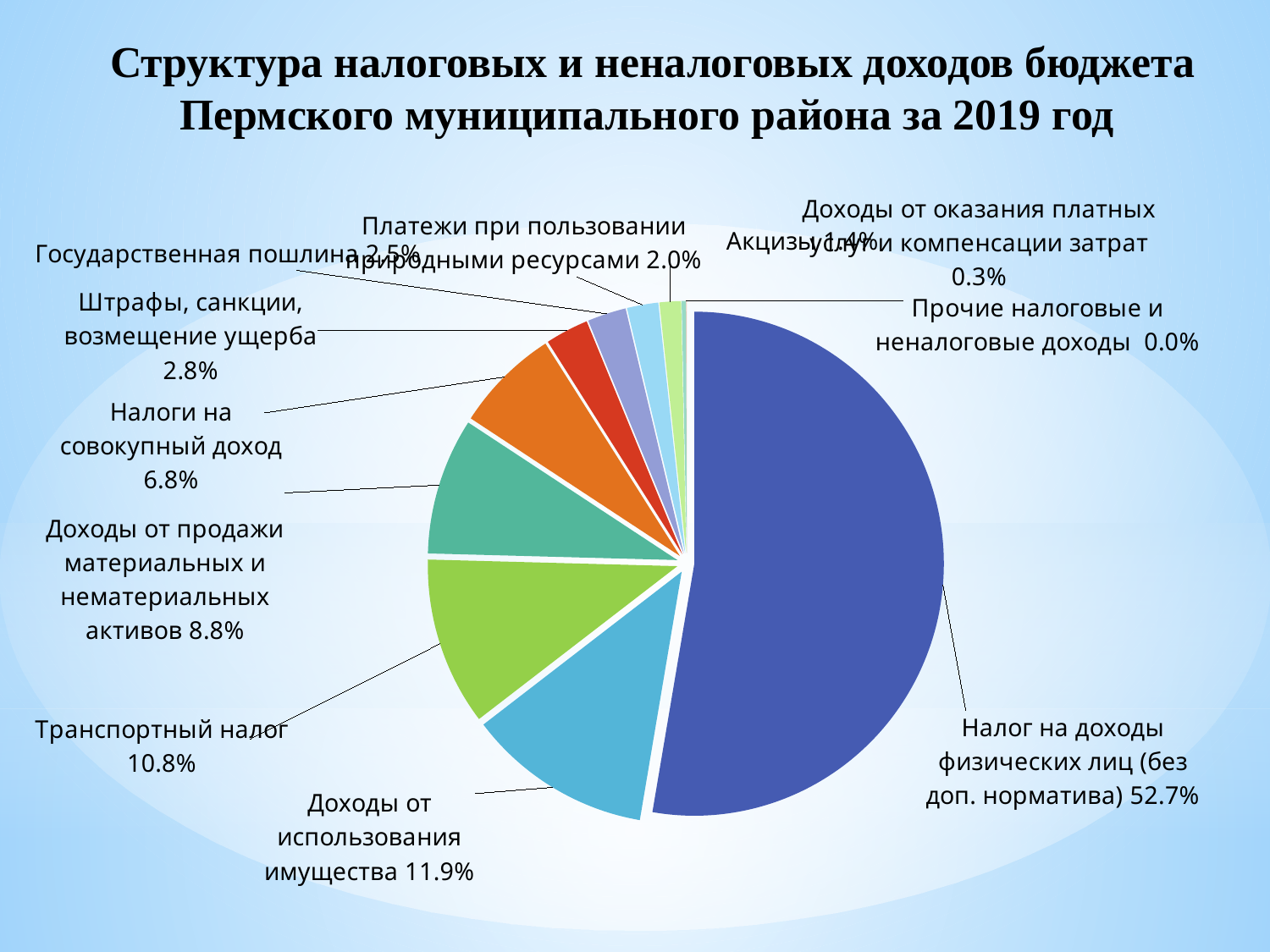
What is the difference in percentage points between Доходы от использования имущества and Транспортный налог? 1.1% What share does Штрафы, санкции, возмещение ущерба have? 2.8% What share does Налоги на совокупный доход have? 6.8% What share does Транспортный налог have? 10.8% Which is larger: the share of Транспортный налог or the share of Налоги на совокупный доход? Транспортный налог Which category has the smallest share of the pie? Прочие налоговые и неналоговые доходы What share does Доходы от продажи материальных и нематериальных активов have? 8.8% What share does Налог на доходы физических лиц (без доп. норматива) have? 52.7% What share does Доходы от использования имущества have? 11.9% Which category has the largest share of the pie? Налог на доходы физических лиц (без доп. норматива) What type of chart is shown on the slide? Pie chart What share does Платежи при пользовании природными ресурсами have? 2.0%